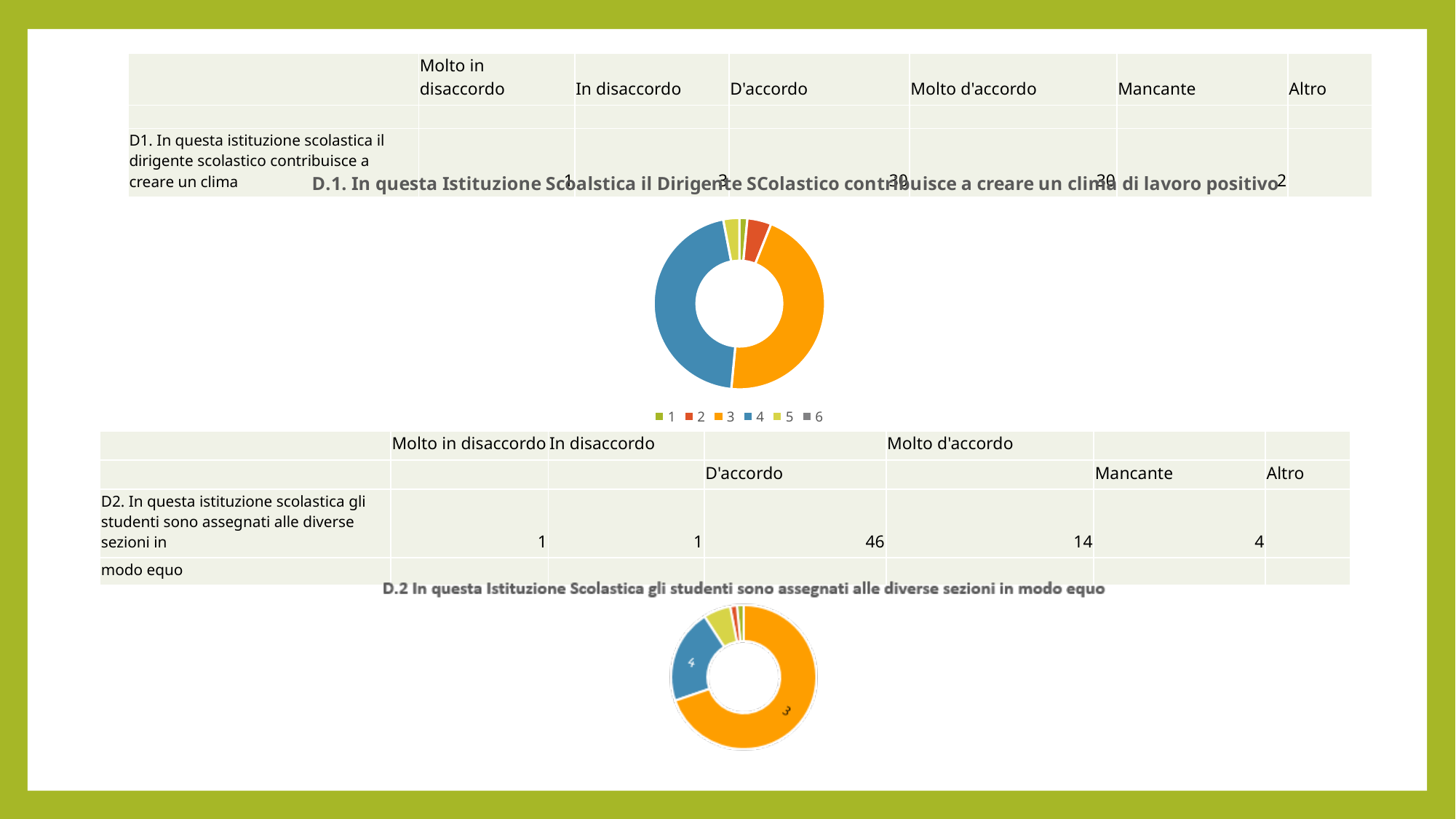
What kind of chart is shown under the title 'D.1. In questa Istituzione Scoalstica il Dirigente SColastico contribuisce a creare un clima di lavoro positivo'? Doughnut (pie) chart What kind of chart is shown under the title 'D.2 In questa Istituzione Scolastica gli studenti sono assegnati alle diverse sezioni in modo equo'? Doughnut (pie) chart In the D.1 chart, which is larger, the slice for category 3 (orange) or the slice for category 2 (red)? Category 3 (orange) In the D.1 chart, how many entries does the legend list? 6 In the D.1 chart, what colour is the slice for legend category 4? Blue In the D.2 chart, which is larger, the slice labelled 3 or the slice labelled 4? 3 According to the D2 table on the slide, what is the difference between the 'D'accordo' count and the 'Molto d'accordo' count for D2? 32 According to the D2 table on the slide, how many respondents answered 'Molto d'accordo' for D2? 14 In the D.2 chart, which slice is the largest? 3 (orange) In the D.1 chart, what are the legend entries? 1, 2, 3, 4, 5, 6 According to the D2 table on the slide, how many respondents answered 'D'accordo' for D2? 46 In the D.1 chart, which legend category has the largest slice? Categories 3 and 4 are tied (30 each)